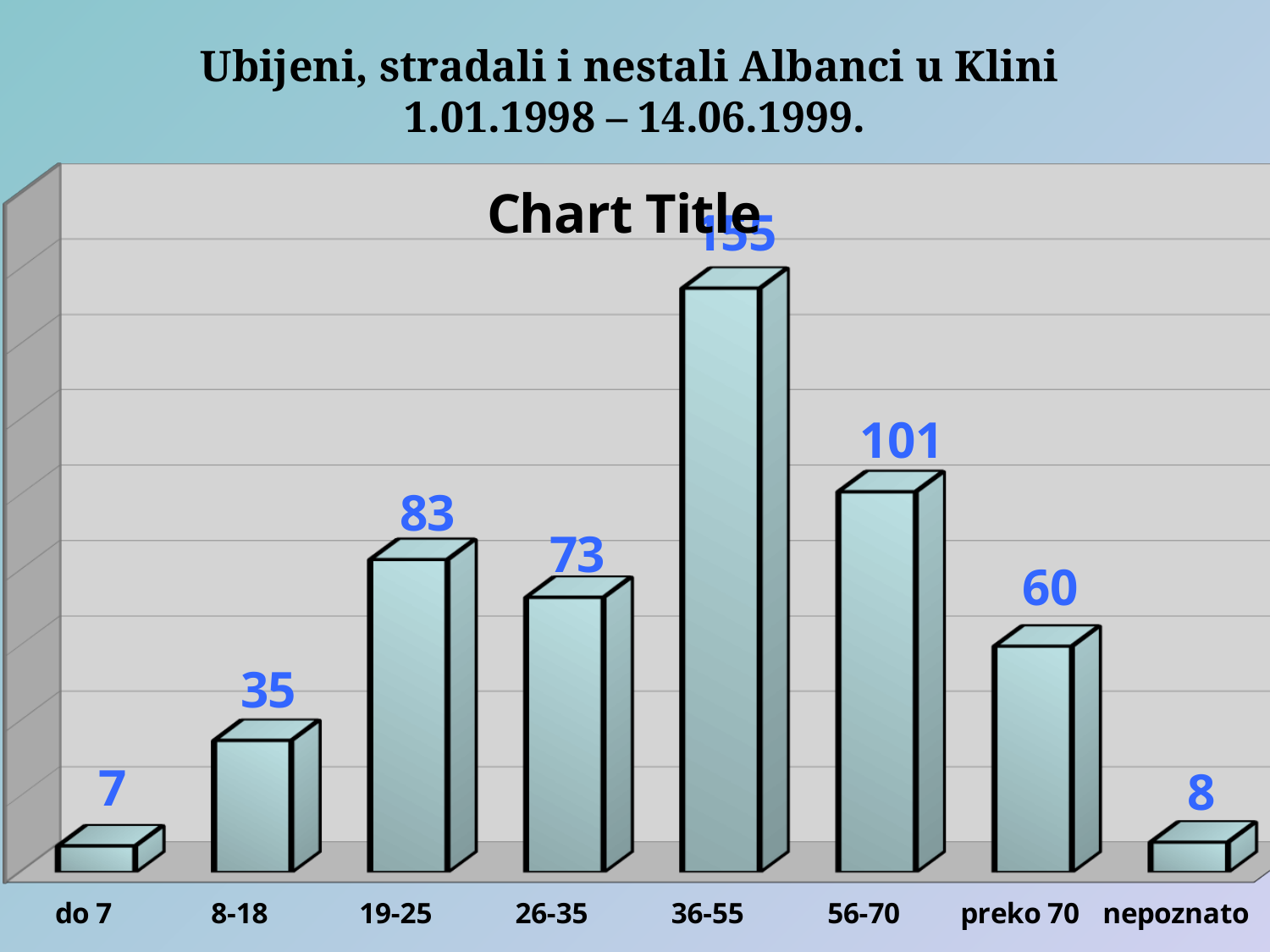
How many categories are shown on the x axis? 8 What kind of chart is shown on the slide? bar chart What is the value for the 'preko 70' category? 60 Which age group has the highest value? 36-55 What is the value for the 8-18 age group? 35 What is the difference between the values for 36-55 and 56-70? 54 What is the title printed above the chart area? Chart Title What is the value for the 36-55 age group? 155 Which category has the lowest value? do 7 What is the value for the 'nepoznato' category? 8 Which is larger, the value for 56-70 or the value for preko 70? 56-70 What is the difference between the values for 19-25 and 26-35? 10